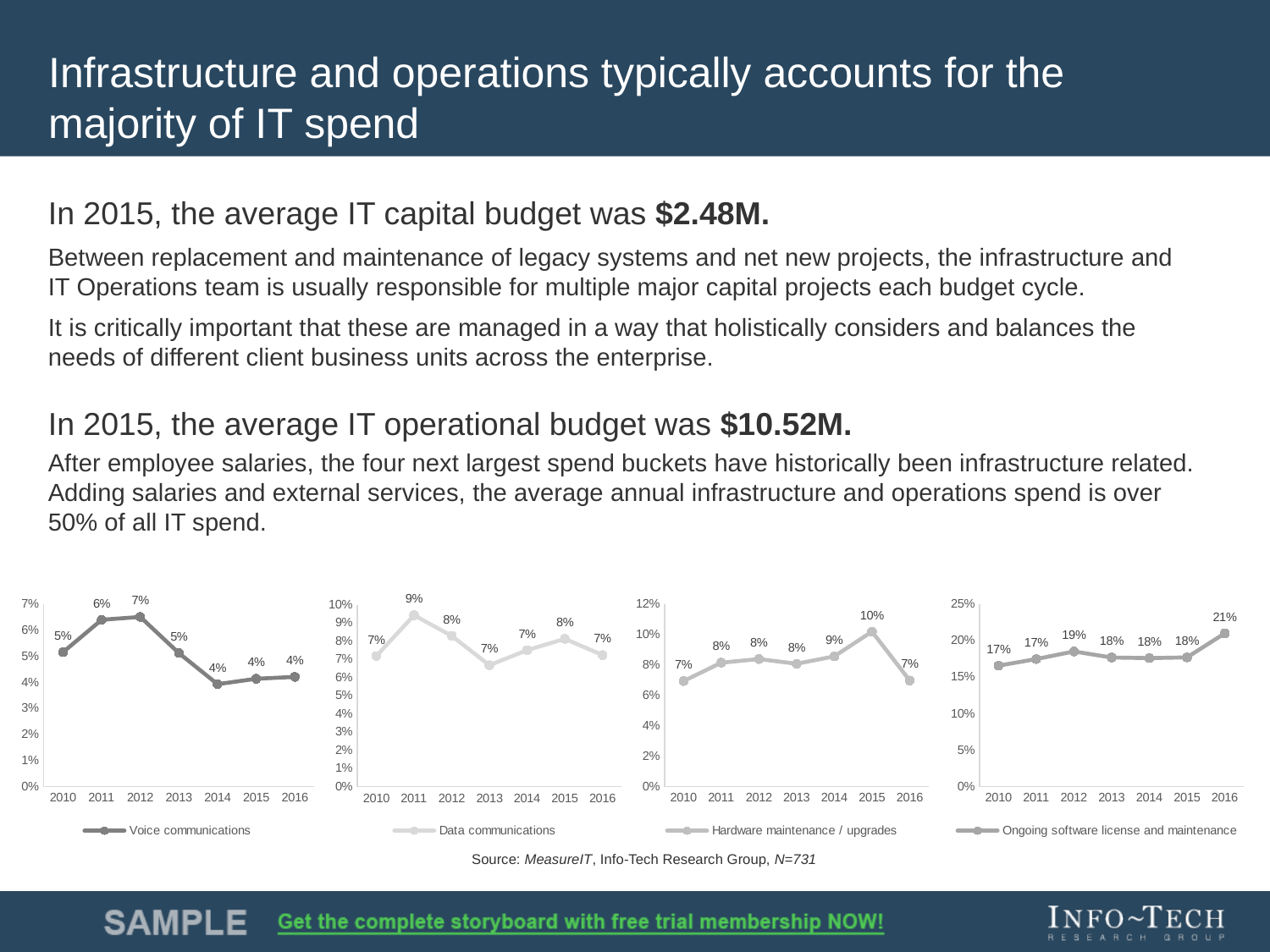
In the Data communications chart (second from left), what is the value for 2011? 9% In the Ongoing software license and maintenance chart (rightmost), what is the difference between the 2016 value and the 2010 value? 4 percentage points In the Hardware maintenance / upgrades chart (third from left), is the value for 2015 larger or smaller than the value for 2016? larger How many years are plotted on the x axis of the Voice communications chart (leftmost)? 7 In the Ongoing software license and maintenance chart (rightmost), is the value for 2016 greater or less than 20%? greater In the Voice communications chart (leftmost), what is the value for 2010? 5% In the Ongoing software license and maintenance chart (rightmost), what is the value for 2016? 21% In the Hardware maintenance / upgrades chart (third from left), which year has the highest value? 2015 In the Data communications chart (second from left), which year has the highest value? 2011 In the Ongoing software license and maintenance chart (rightmost), which year has the highest value? 2016 In the Hardware maintenance / upgrades chart (third from left), what is the value for 2015? 10% What kind of chart is the Data communications chart (second from left)? line chart